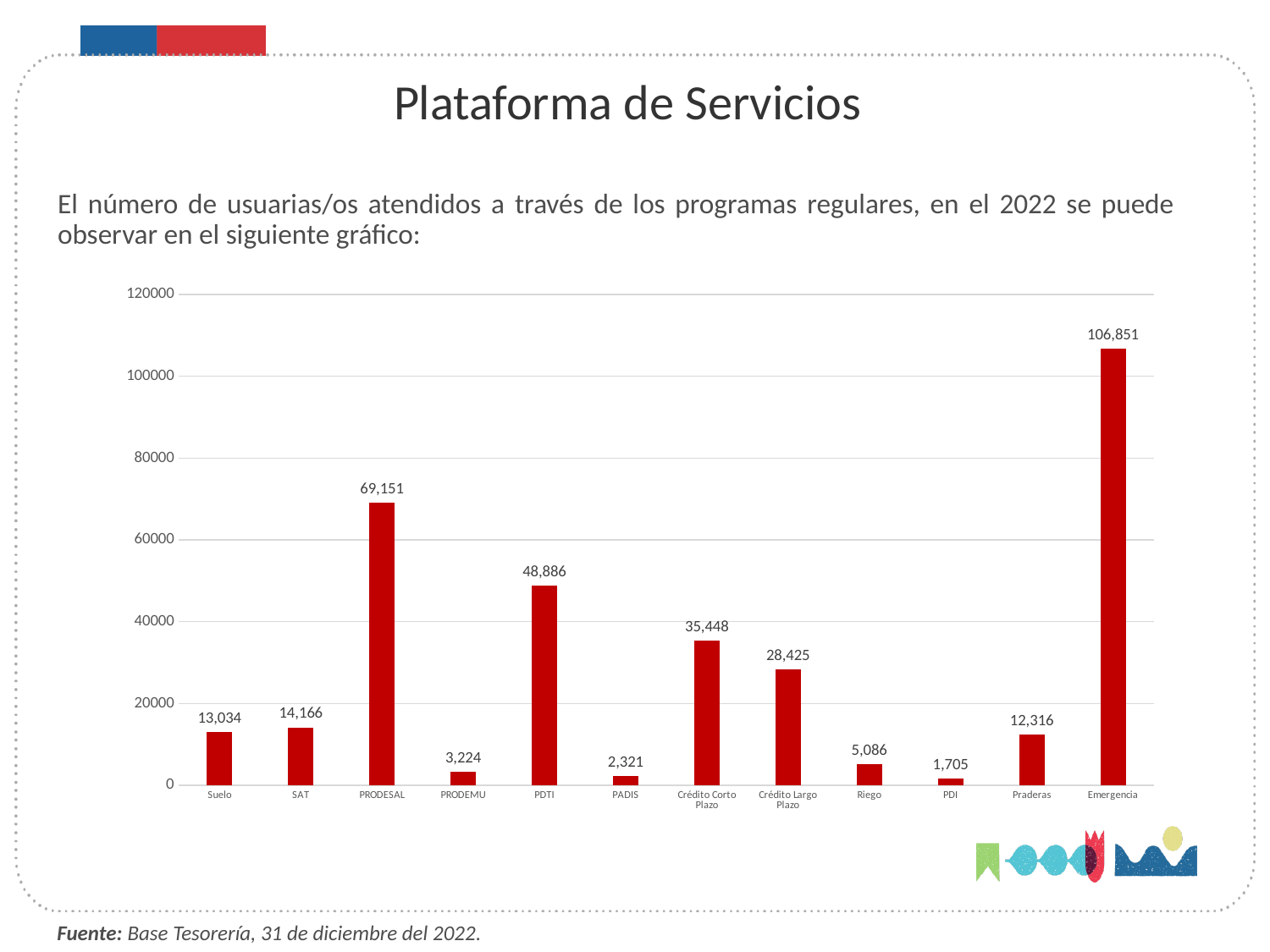
What is the value for Crédito Largo Plazo? 28,425 Which category has the lowest value? PDI How many categories are shown on the x axis? 12 What is the difference between the values for PRODESAL and PDTI? 20,265 What is the value for Praderas? 12,316 What is the difference between the values for Crédito Corto Plazo and Crédito Largo Plazo? 7,023 What kind of chart is shown on the slide? bar chart Which category has the highest value? Emergencia What is the value for PRODESAL? 69,151 Which is larger, the value for SAT or the value for Suelo? SAT What colour are the bars in the chart? red Is the value for Emergencia greater or less than 100000? greater